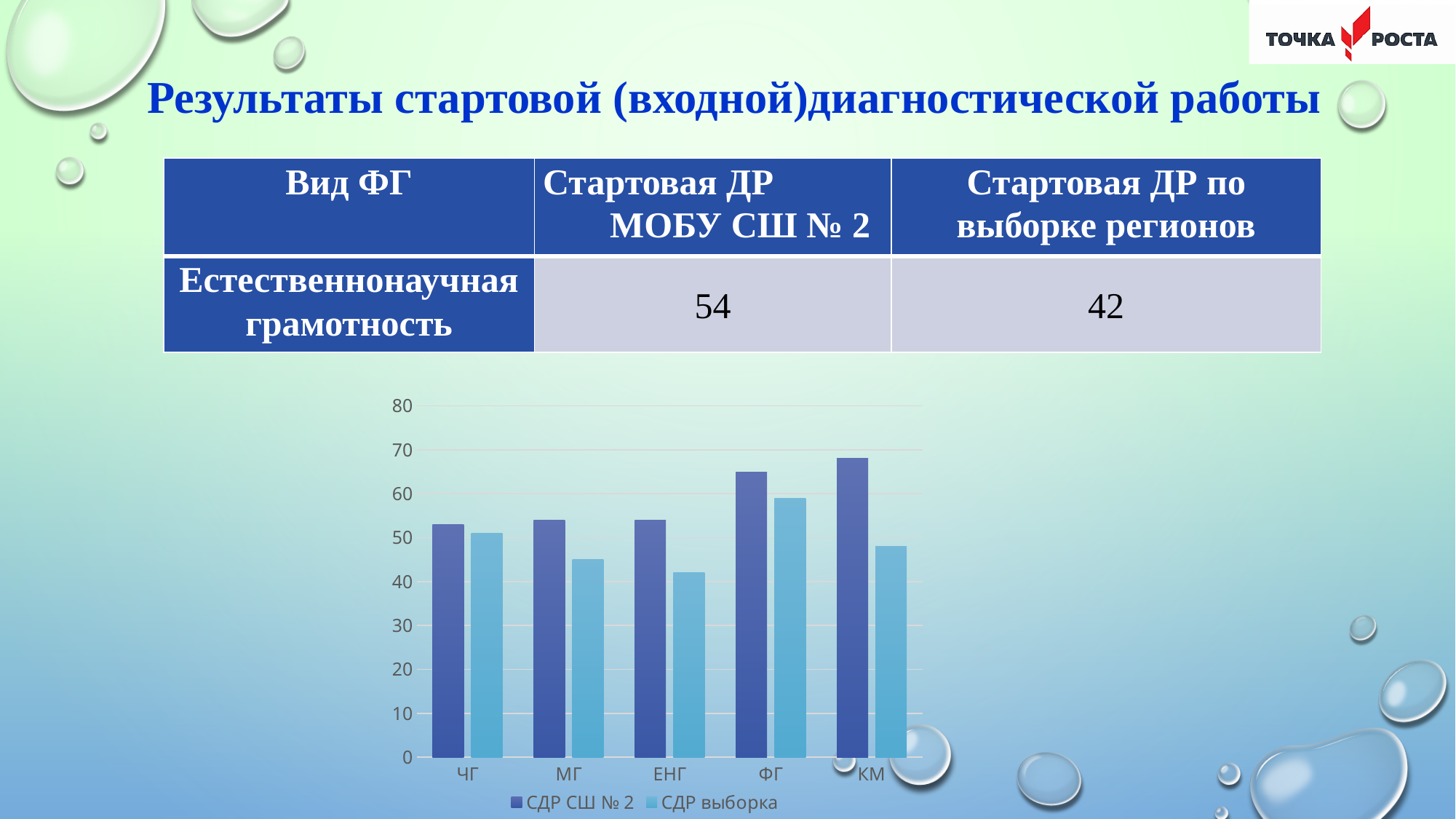
Is the value for ЧГ in the СДР СШ № 2 series greater or less than 50? greater Which category has the highest value for the СДР СШ № 2 series? КМ Which category has the lowest value for the СДР выборка series? ЕНГ What are the two series named in the chart legend? СДР СШ № 2 and СДР выборка For the СДР СШ № 2 series, which is larger: ФГ or ЧГ? ФГ Is the value for КМ in the СДР СШ № 2 series greater or less than 60? greater How many categories are shown on the x axis of the chart? 5 Which category has the highest value for the СДР выборка series? ФГ Is the value for МГ in the СДР выборка series greater or less than 50? less How many series does the chart legend list? 2 What kind of chart is shown on the slide? bar chart For the category КМ, which series has the larger value: СДР СШ № 2 or СДР выборка? СДР СШ № 2